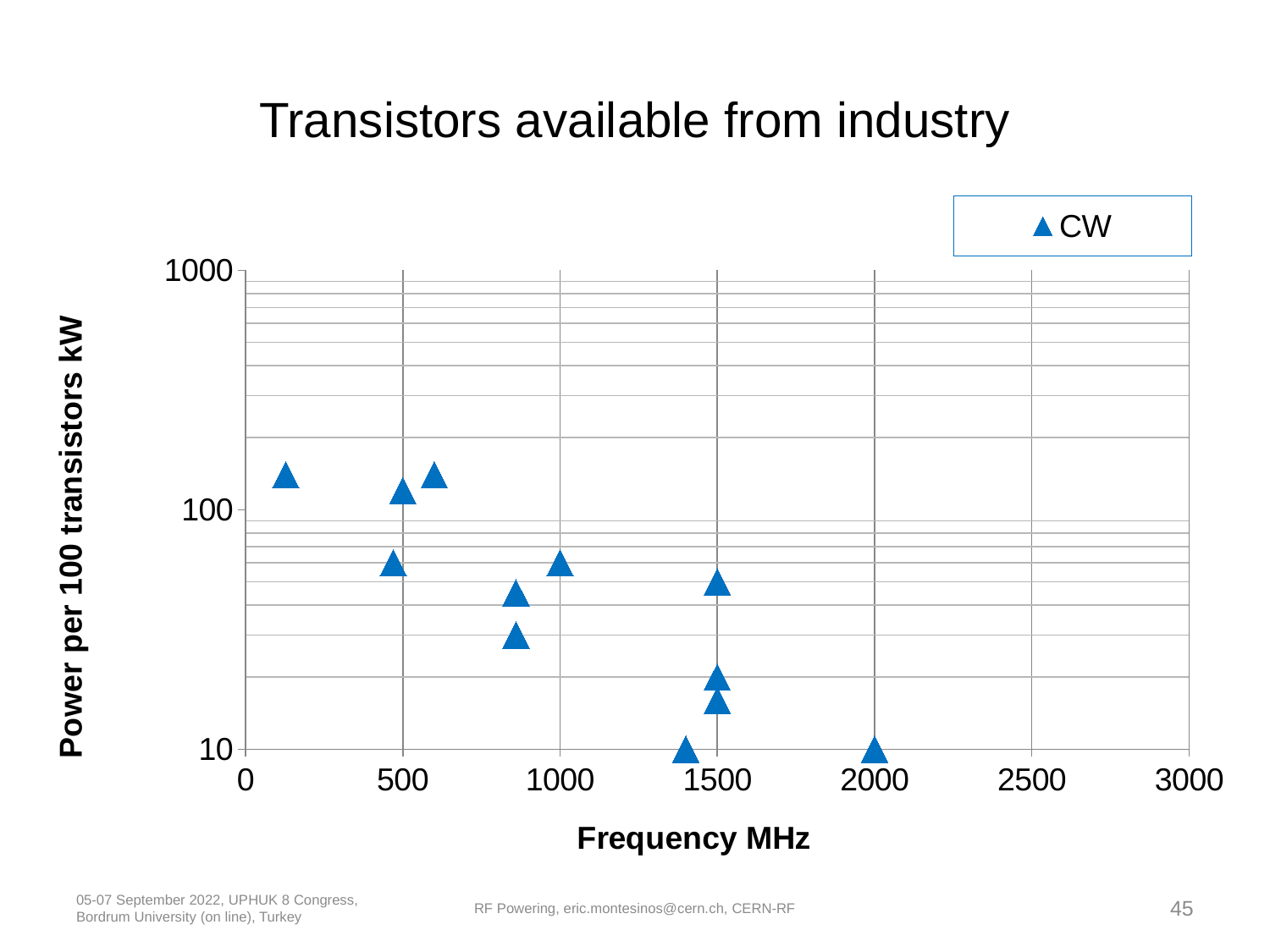
Is the power value for the point near 130 MHz greater or less than 100 kW? greater What is the title of the chart? Transistors available from industry What kind of chart is shown on the slide? Scatter chart How many series does the legend list? 1 How many data points are plotted on the chart? 12 Which has the higher power value: the point at 600 MHz or the point at 2000 MHz? 600 MHz What is the name of the series shown in the legend? CW How many data points are plotted at 1500 MHz? 3 Overall, do the power values rise or fall as frequency increases along the x axis? fall Which has the higher power value: the point at 1000 MHz or the point at 1400 MHz? 1000 MHz Is the power value for the point at 1000 MHz greater or less than 100 kW? less Is the power value for the point at 2000 MHz greater or less than 100 kW? less